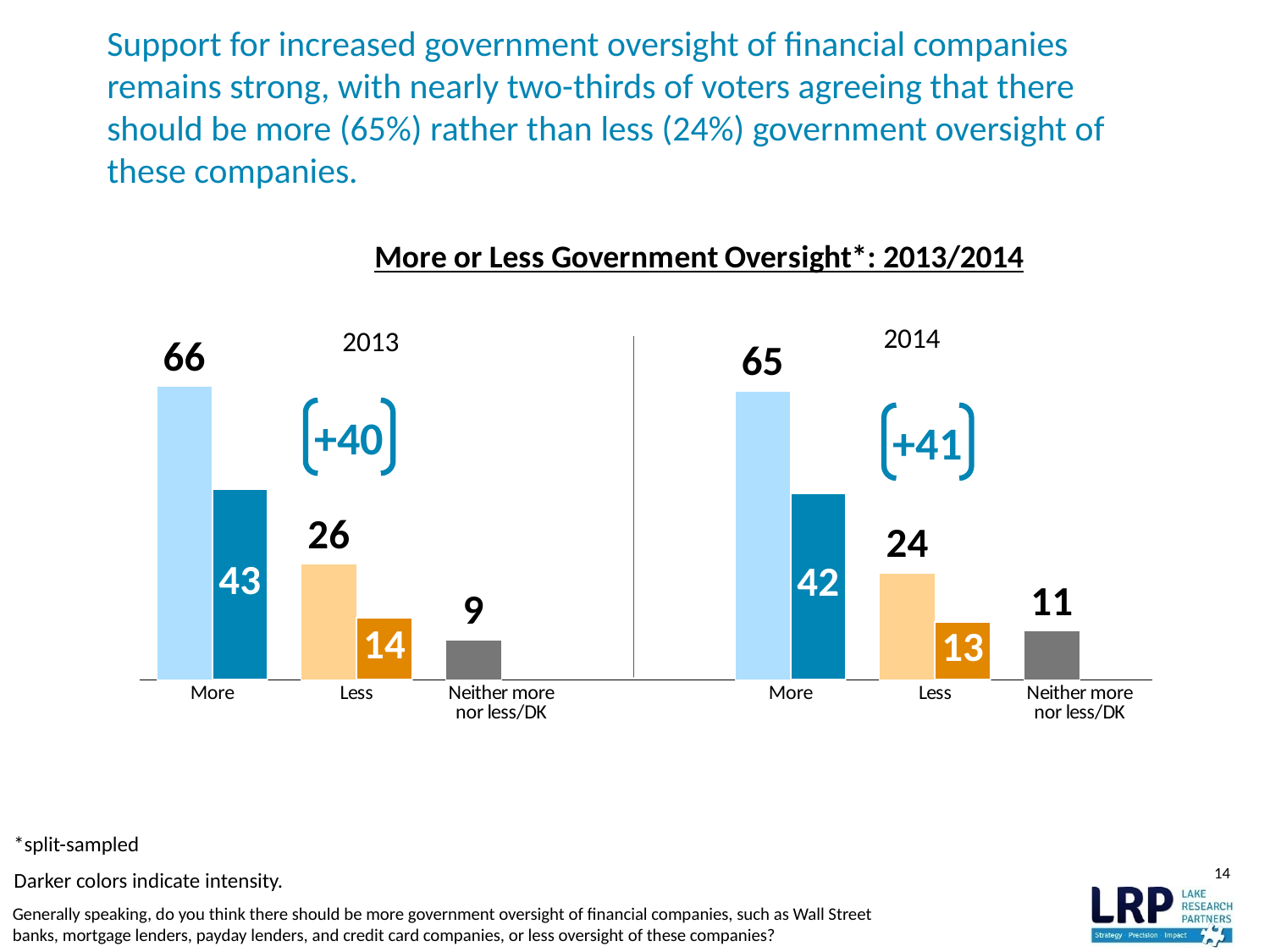
In the 2013 chart, which category has the lowest value? Neither more nor less/DK Which is larger: the value for More in 2013 or the value for More in 2014? More in 2013 How many categories are shown in the 2014 chart? 3 In the 2014 chart, which category has the highest value? More In the 2014 chart, what is the difference between the values for More and Less? 41 In the 2014 chart, what is the value for Neither more nor less/DK? 11 In the 2013 chart, what is the value for More? 66 In the 2014 chart, what is the value shown on the darker bar for Less? 13 What kind of chart is used on this slide? Bar chart In the 2013 chart, what is the difference between the values for More and Less? 40 In the 2013 chart, what is the value shown on the darker bar for More? 43 In the 2014 chart, what is the value for Less? 24